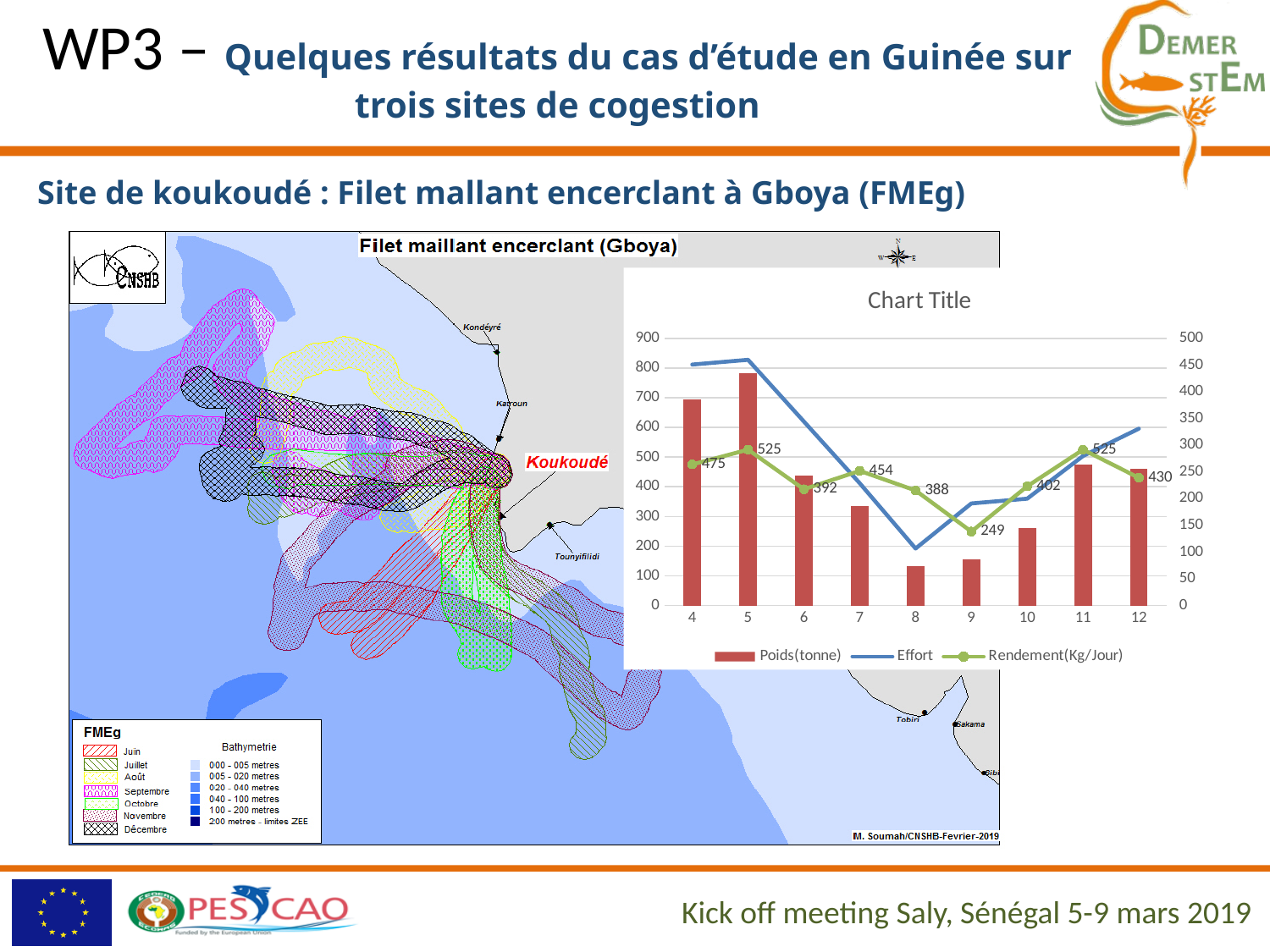
What is the Rendement(Kg/Jour) value for month 4? 475 How many series does the chart legend list? 3 What is the difference between the Rendement(Kg/Jour) values for month 5 and month 9? 276 Is the Poids(tonne) bar for month 8 greater or less than 200? less Which month has the larger Rendement(Kg/Jour) value, month 6 or month 7? 7 What is the difference between the Rendement(Kg/Jour) values for month 12 and month 10? 28 What is the Rendement(Kg/Jour) value for month 9? 249 Do the Poids(tonne) bars rise or fall from month 4 to month 8? fall What is the Rendement(Kg/Jour) value for month 12? 430 How many months are shown on the x axis of the chart? 9 Which month has the lowest Rendement(Kg/Jour) value? 9